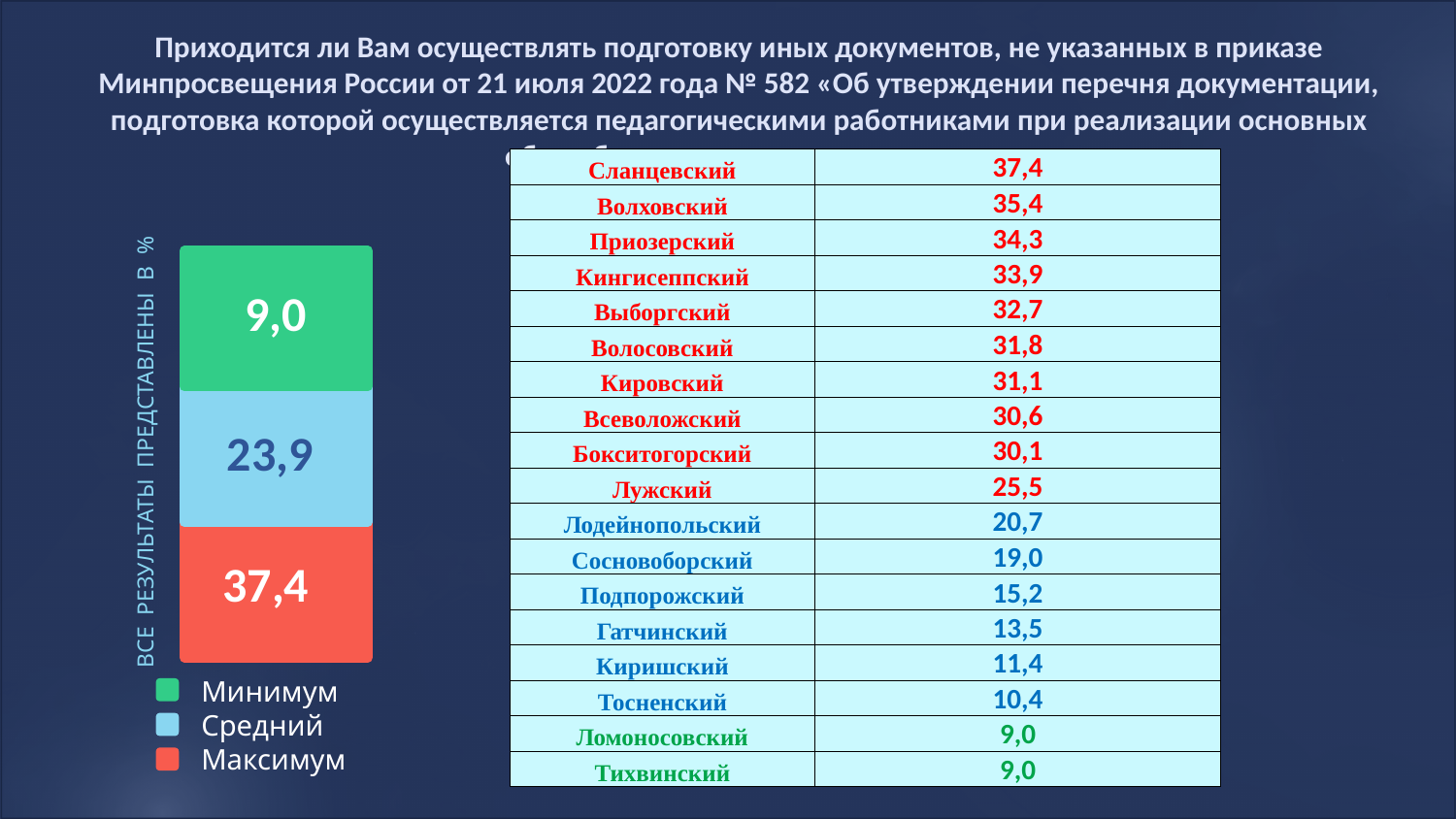
What is the difference between the Максимум and Минимум values in the stacked bar chart? 28,4 Which colour represents Минимум in the stacked bar chart legend? Green What is the value of the Максимум segment in the stacked bar chart? 37,4 How many series does the legend of the stacked bar chart list? 3 What is the value of the Минимум segment in the stacked bar chart? 9,0 What is the value of the Средний segment in the stacked bar chart? 23,9 What is the total of the three segments in the stacked bar? 70,3 Which segment of the stacked bar has the highest value? Максимум What is the difference between the Средний and Минимум values in the stacked bar chart? 14,9 Which segment of the stacked bar has the lowest value? Минимум Which is larger in the stacked bar chart, the Средний value or the Максимум value? Максимум What kind of chart is shown on the left of the slide? Stacked bar chart